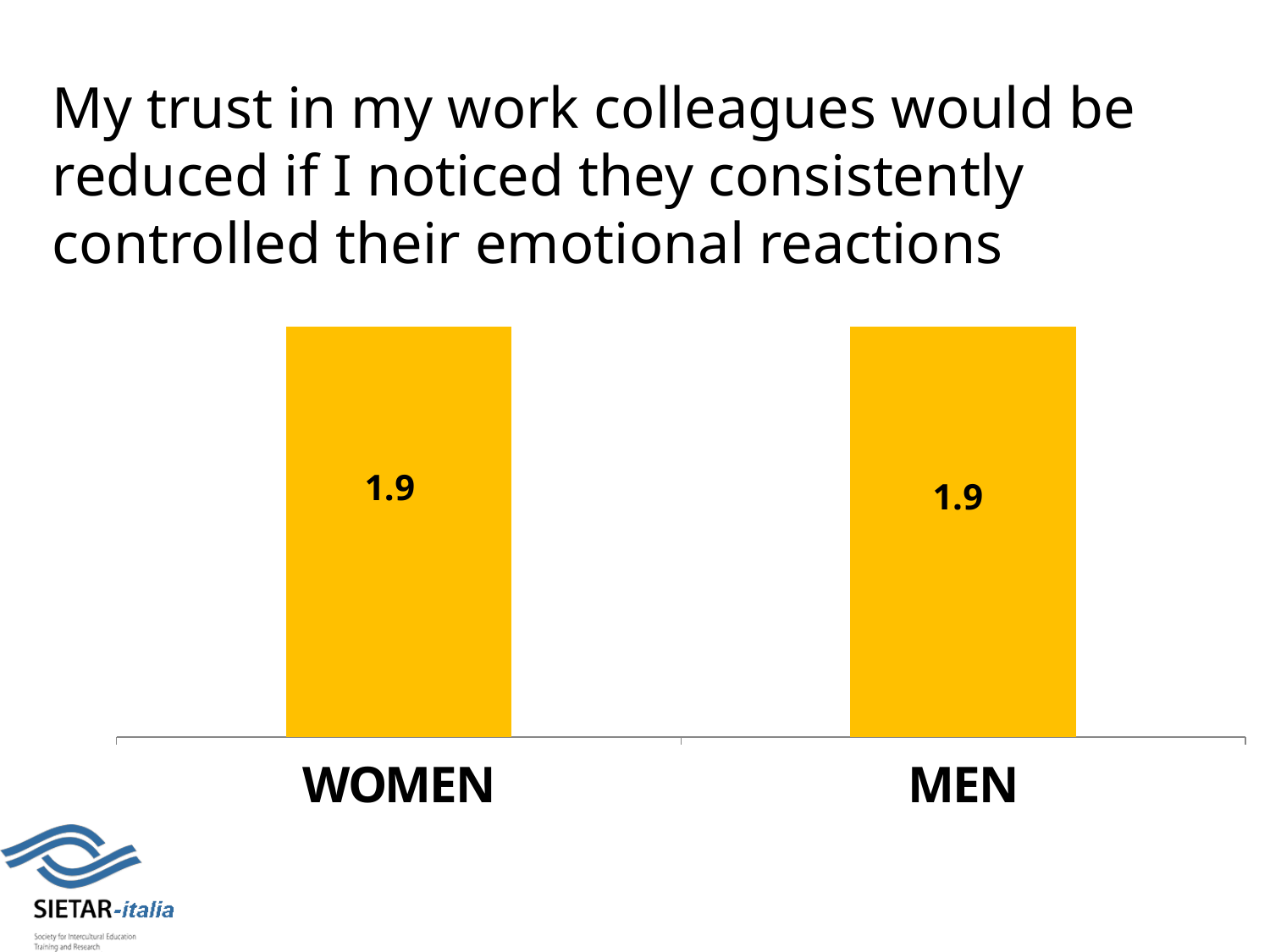
What are the two category labels on the x axis? WOMEN and MEN What colour are the bars in the chart? Yellow What is the difference between the values for WOMEN and MEN? 0 What is the value for MEN? 1.9 How many categories are shown in the chart? 2 What kind of chart is shown on the slide? bar chart Are the values for WOMEN and MEN equal? Yes What is the total of the values for WOMEN and MEN? 3.8 What is the value for WOMEN? 1.9